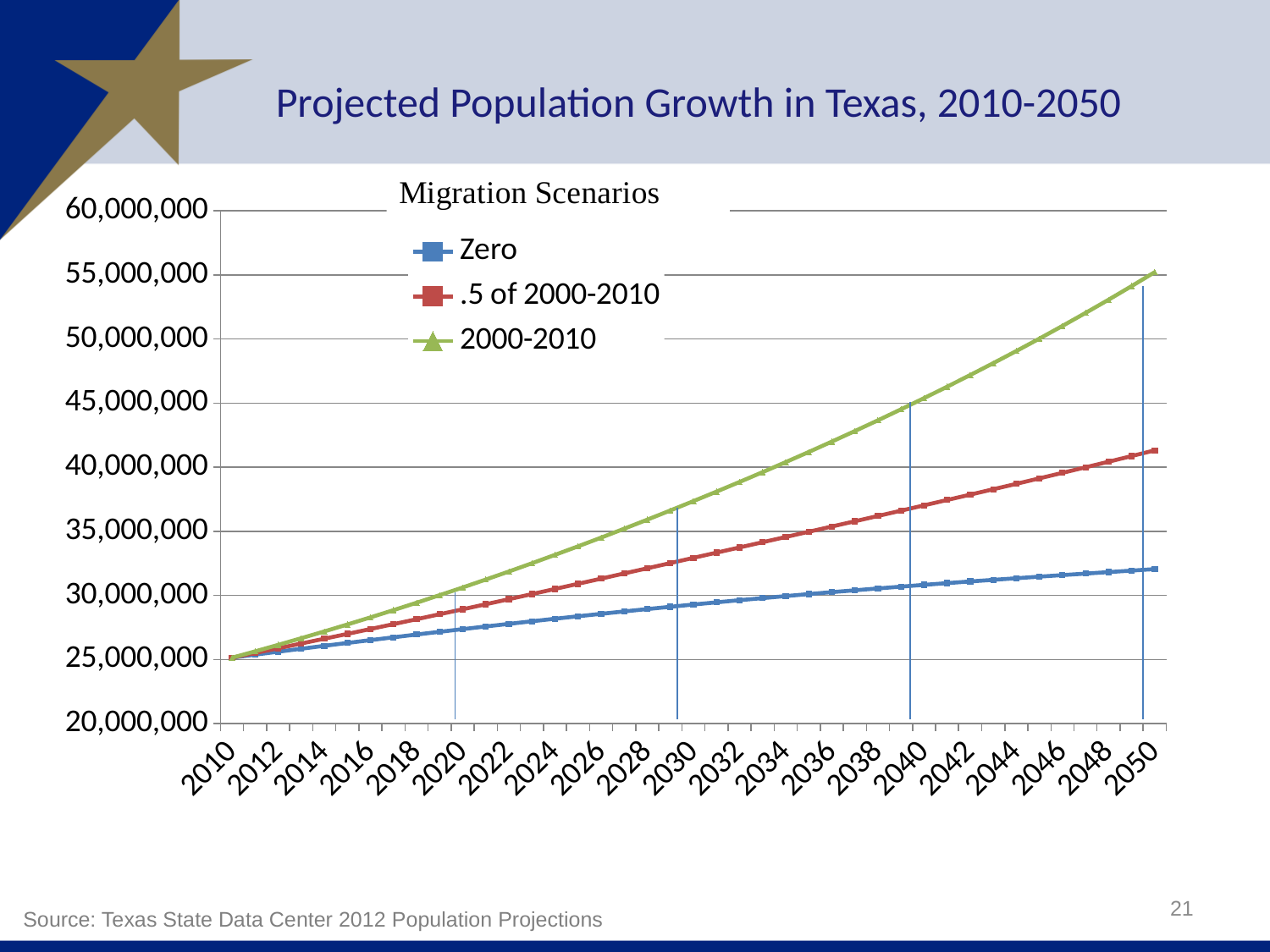
How many year labels are shown on the x axis? 21 Do the projected populations rise or fall from 2010 to 2050? rise What is the title shown above the legend? Migration Scenarios Is the projected population for the Zero scenario in 2050 greater or less than 35,000,000? less Is the projected population for the Zero scenario in 2030 greater or less than 30,000,000? less How many series does the legend list? 3 What kind of chart is shown on the slide? line chart Which migration scenario has the lowest projected population in 2050? Zero Is the projected population for the 2000-2010 scenario in 2030 greater or less than 35,000,000? greater In 2040, which is larger: the projected population under the 2000-2010 scenario or under the Zero scenario? 2000-2010 Which migration scenario has the highest projected population in 2050? 2000-2010